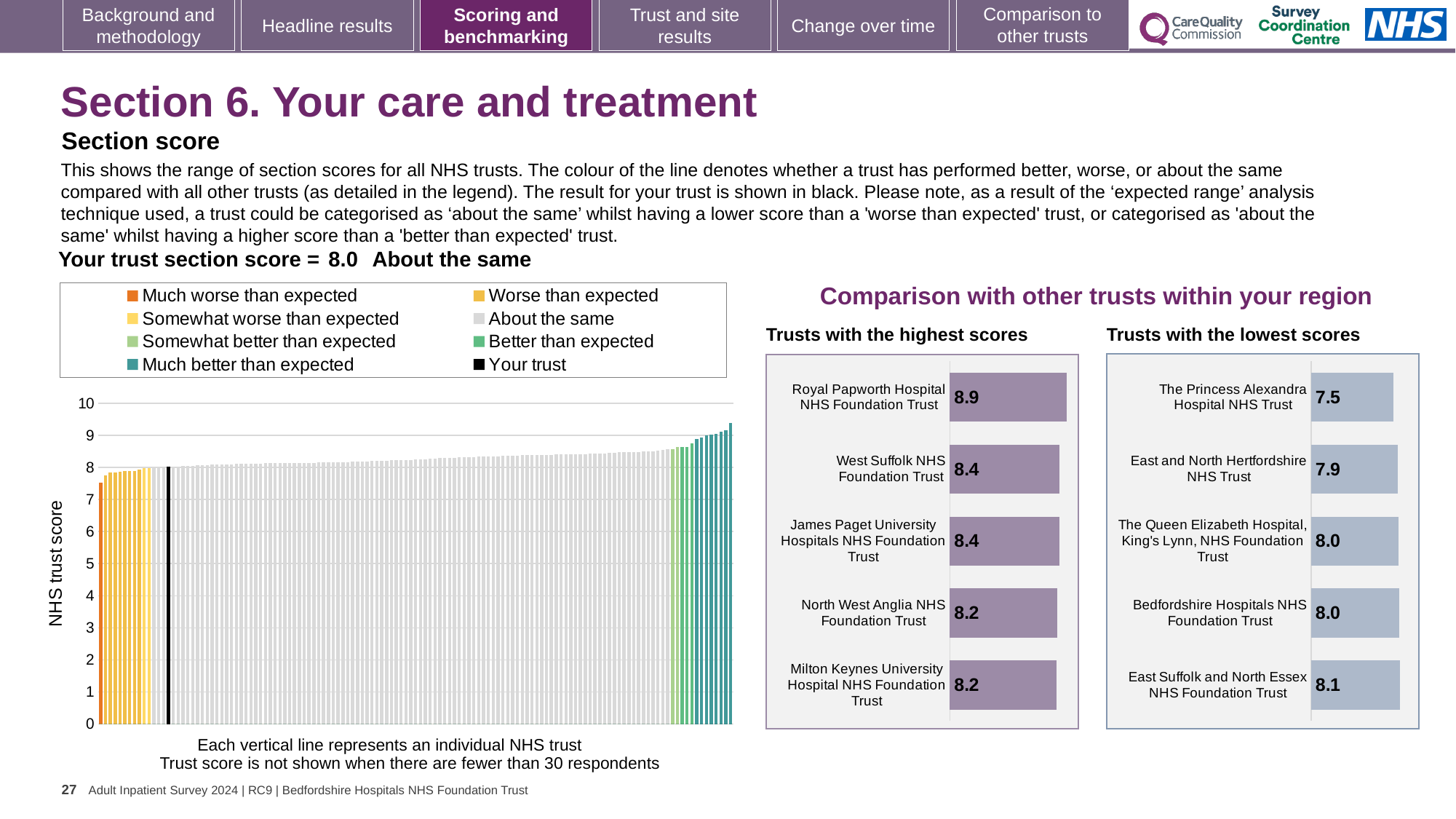
How many entries does the legend of the main NHS trust score chart list? 8 In the main NHS trust score chart, what is your trust's section score? 8.0 In the 'Trusts with the highest scores' chart, which trust has the highest score? Royal Papworth Hospital NHS Foundation Trust In the main NHS trust score chart, do the trust scores rise or fall from left to right? Rise In the 'Trusts with the highest scores' chart, what is the score for Royal Papworth Hospital NHS Foundation Trust? 8.9 What kind of chart is the 'Trusts with the lowest scores' chart? Bar chart How many trusts are shown in the 'Trusts with the highest scores' chart? 5 Which has the higher score: North West Anglia NHS Foundation Trust in the 'Trusts with the highest scores' chart or East and North Hertfordshire NHS Trust in the 'Trusts with the lowest scores' chart? North West Anglia NHS Foundation Trust In the 'Trusts with the lowest scores' chart, what is the difference between the scores of East Suffolk and North Essex NHS Foundation Trust and The Princess Alexandra Hospital NHS Trust? 0.6 In the 'Trusts with the lowest scores' chart, which trust has the lowest score? The Princess Alexandra Hospital NHS Trust In the 'Trusts with the highest scores' chart, what is the difference between the scores of Royal Papworth Hospital NHS Foundation Trust and West Suffolk NHS Foundation Trust? 0.5 In the 'Trusts with the lowest scores' chart, what is the score for The Princess Alexandra Hospital NHS Trust? 7.5